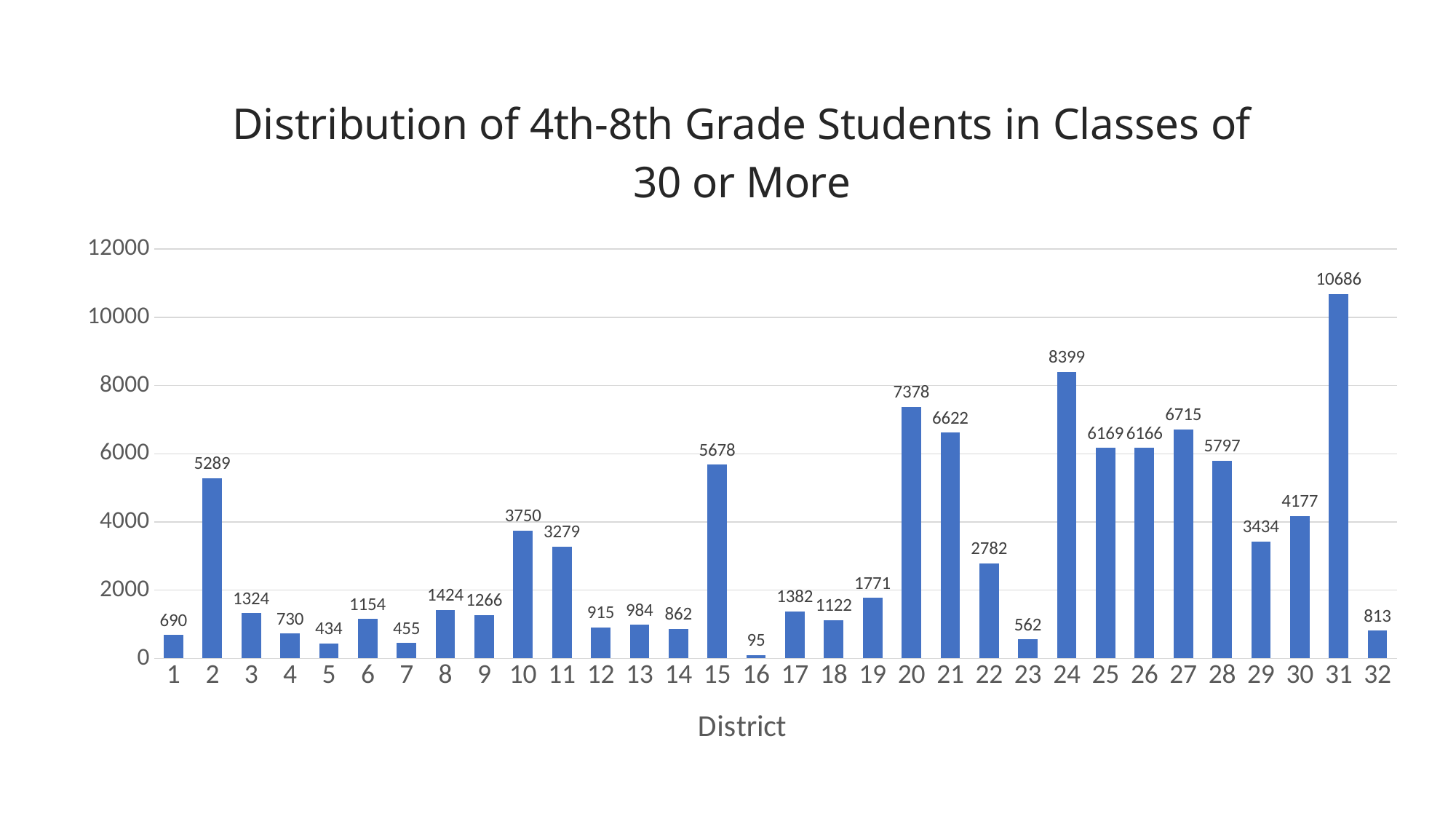
What is the value for District 24? 8399 Which district has the highest value? 31 What is the value for District 15? 5678 Which district has the lowest value? 16 What kind of chart is shown on the slide? Bar chart Which has a larger value, District 2 or District 10? District 2 Is the value for District 27 greater or less than 6000? greater What is the difference between the values for District 20 and District 21? 756 What is the difference between the values for District 31 and District 32? 9873 What is the label of the x axis? District How many districts are shown on the x axis? 32 What is the title of the chart? Distribution of 4th-8th Grade Students in Classes of 30 or More